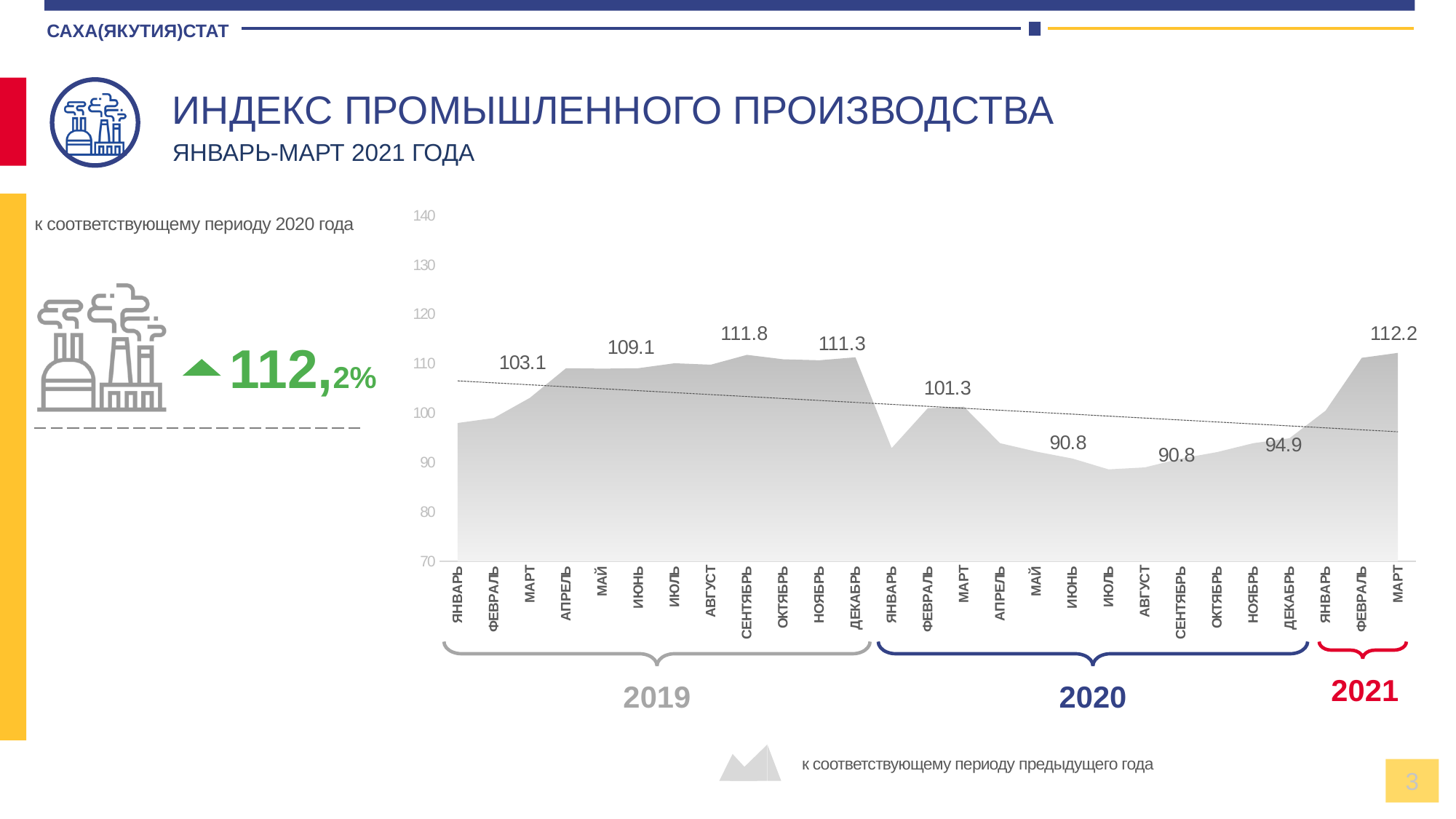
Which labeled point on the chart has the highest value? March 2021 (112.2) What is the difference between the labeled values for March 2021 and March 2020? 10.9 Is the value for January 2020 (ЯНВАРЬ 2020) greater or less than 100? less What is the value of the industrial production index for March 2021 (МАРТ 2021)? 112.2 How many monthly points are plotted on the x axis of the chart? 27 What is the lowest value labeled on the chart? 90.8 What type of chart is shown on the slide? Area chart Which is larger: the labeled value for June 2019 or for June 2020? June 2019 What value is labeled for March 2020 (МАРТ 2020)? 101.3 What is the difference between the labeled values for December 2019 and December 2020? 16.4 What value is labeled for December 2020 (ДЕКАБРЬ 2020)? 94.9 What value is labeled for September 2019 (СЕНТЯБРЬ 2019)? 111.8